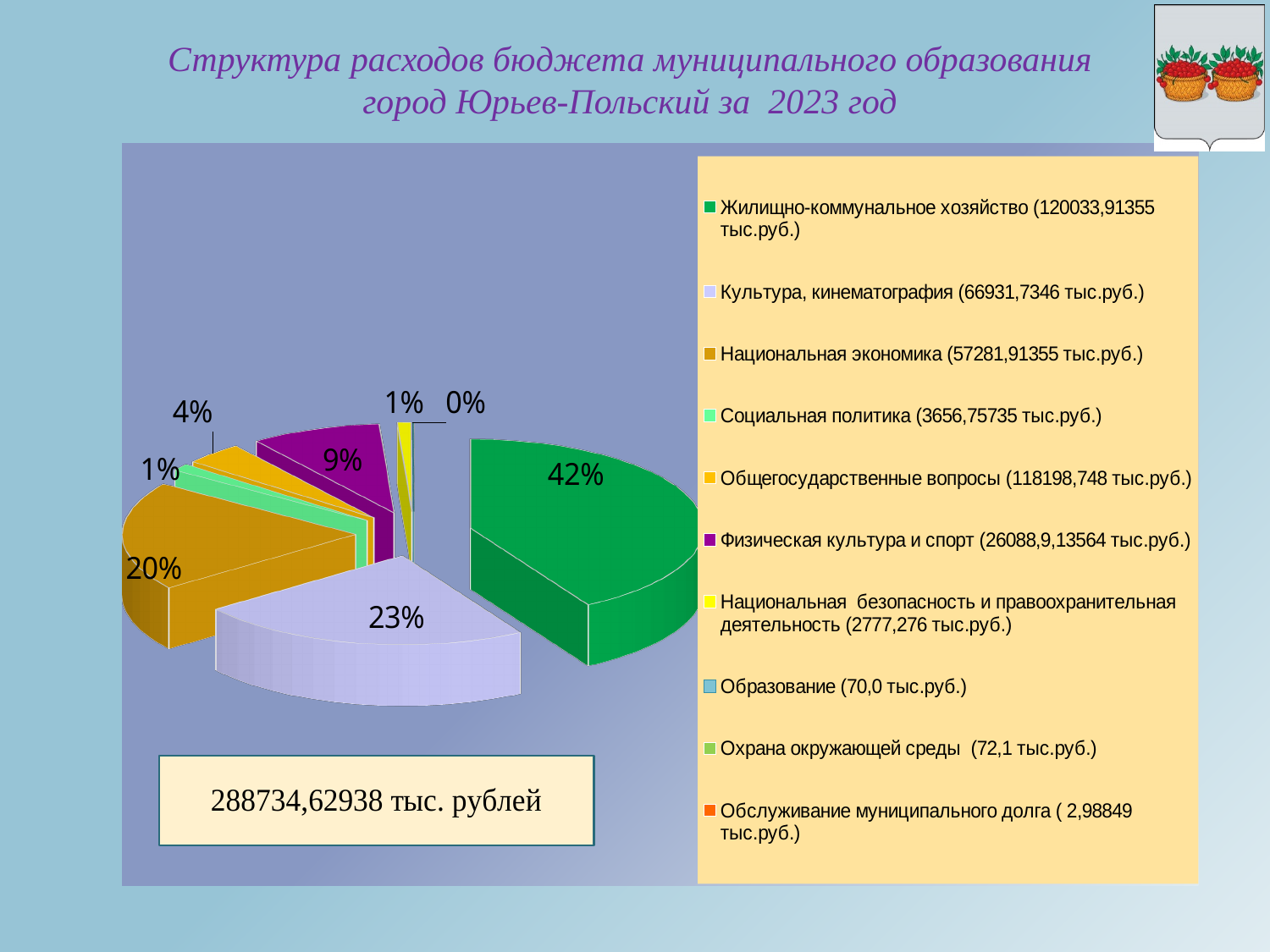
How many entries does the legend list? 10 What share of the pie does Физическая культура и спорт take? 9% What share of the pie does Культура, кинематография take? 23% By how many percentage points does the Жилищно-коммунальное хозяйство slice exceed the Культура, кинематография slice? 19 percentage points Which category has the largest slice of the pie? Жилищно-коммунальное хозяйство What share of the pie does Национальная экономика take? 20% What kind of chart is shown on the slide? pie chart What value is given in the legend for Культура, кинематография? 66931,7346 тыс.руб. What value is given in the legend for Национальная экономика? 57281,91355 тыс.руб. What total amount is shown in the box below the pie chart? 288734,62938 тыс. рублей Which slice is larger: Культура, кинематография or Национальная экономика? Культура, кинематография